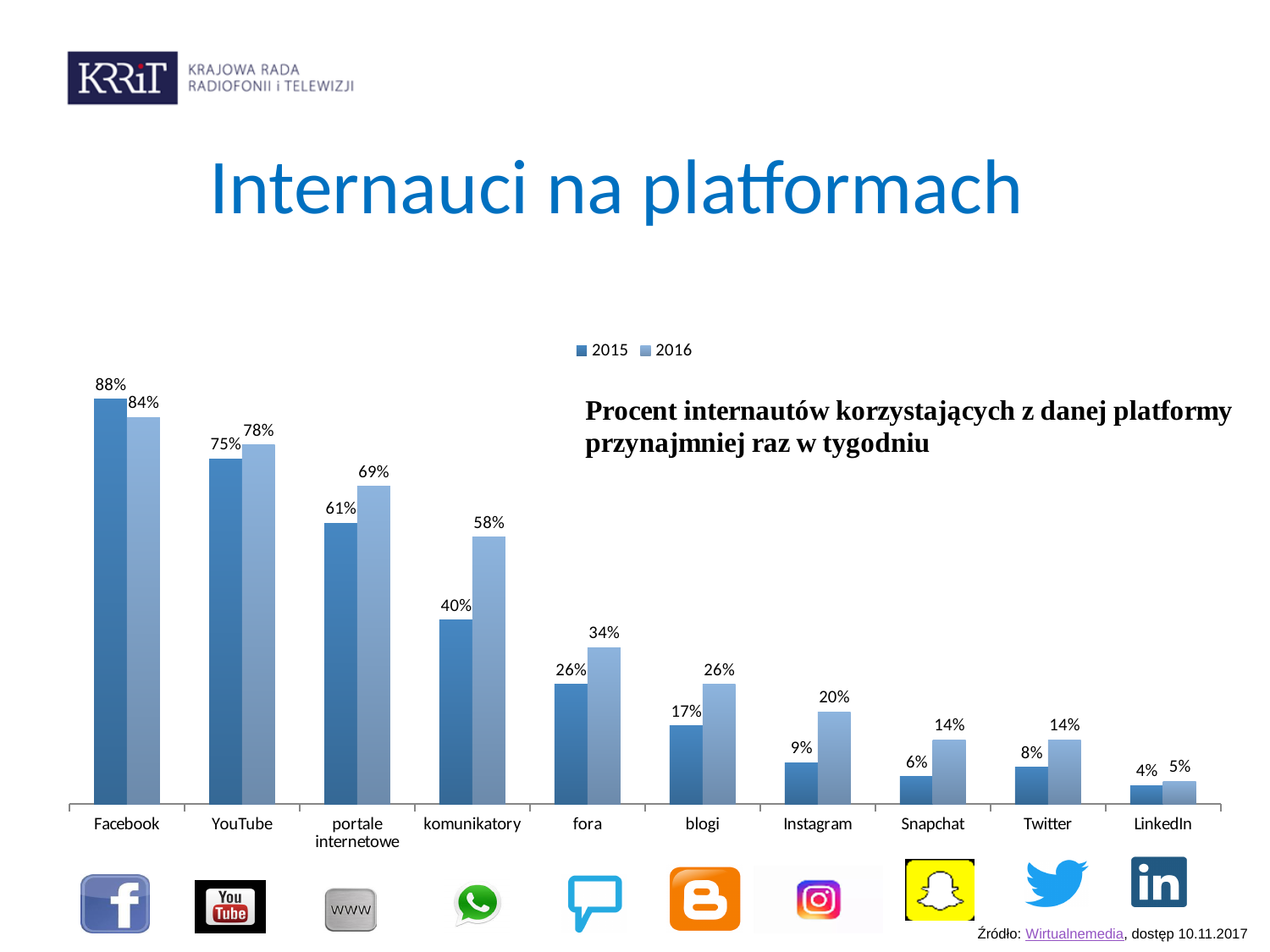
What kind of chart is shown on the slide? bar chart Which series is shown in the darker blue colour? 2015 What is the value for komunikatory in 2016? 58% Which is larger: the 2015 value for YouTube or the 2015 value for portale internetowe? YouTube Do the 2016 values rise or fall from Facebook to LinkedIn along the x axis? fall What is the value for Facebook in 2015? 88% What is the value for Instagram in 2016? 20% What is the difference between the 2016 and 2015 values for komunikatory? 18% Which category has the highest value in 2016? Facebook How many categories are shown on the x axis? 10 How many series does the legend list? 2 Which category has the lowest value in 2015? LinkedIn